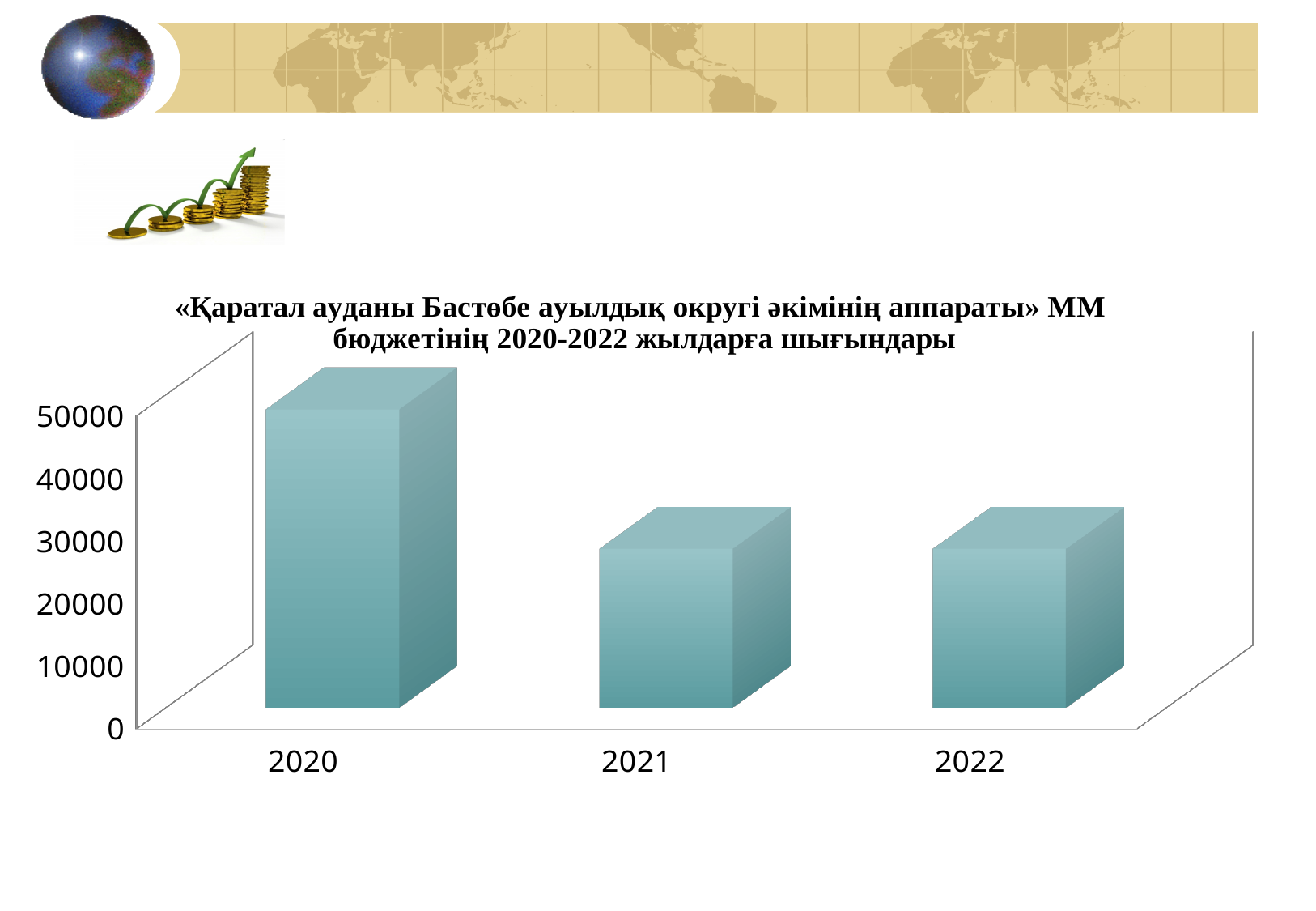
Is the value for 2022 greater or less than 40000? less How many years (categories) are shown on the x axis of the chart? 3 What is the highest tick value shown on the vertical axis of the chart? 50000 Is the value for 2022 greater or less than 20000? greater Is the value for 2020 greater or less than 40000? greater Which is larger, the value for 2020 or the value for 2021? 2020 Does the value rise or fall from 2020 to 2021? fall What kind of chart is shown on the slide? bar chart Which is larger, the value for 2020 or the value for 2022? 2020 Which year has the highest value in the chart? 2020